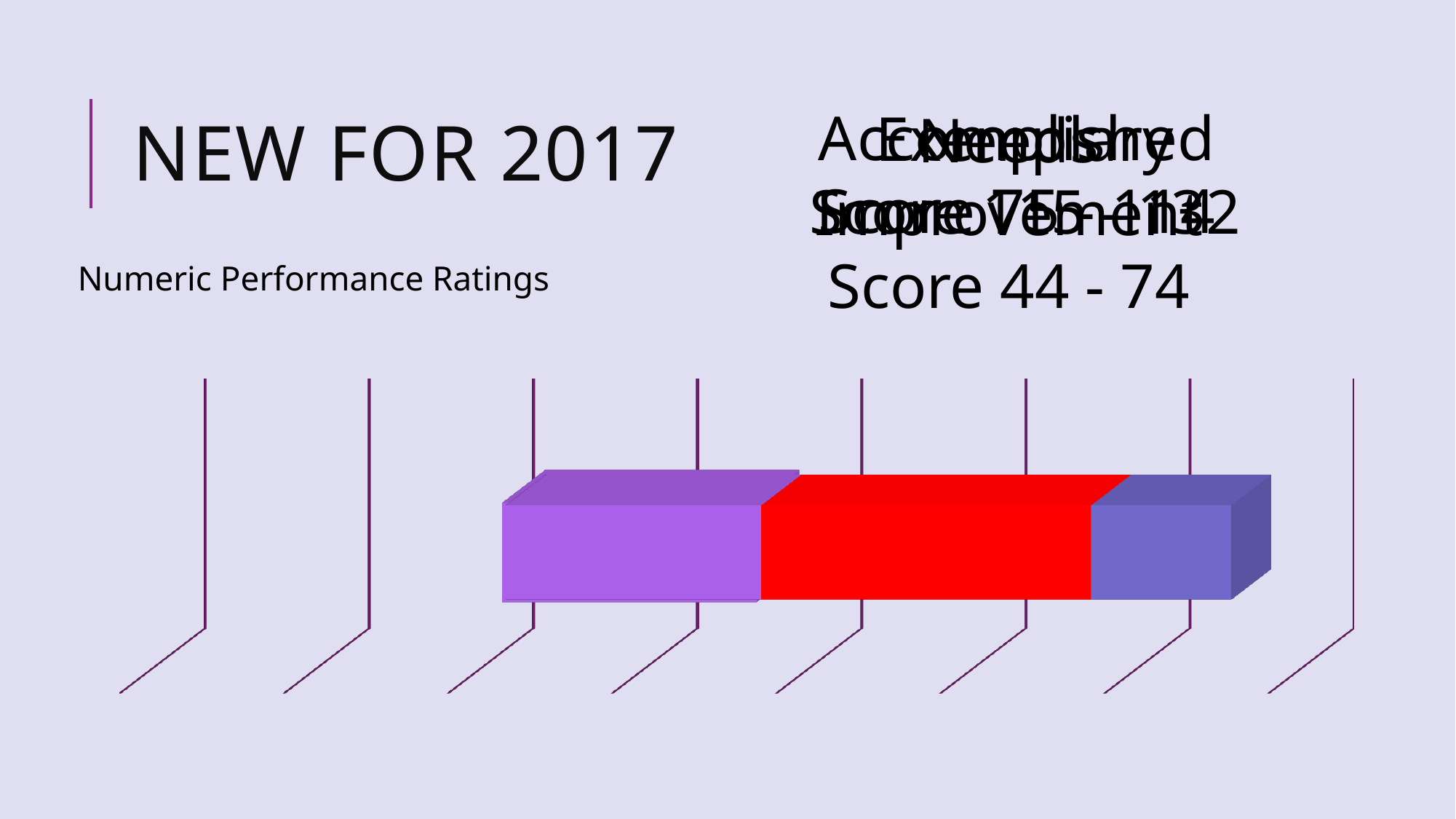
Is the red segment of the bar longer or shorter than the purple segment? longer Is the bar in the chart drawn horizontally or vertically? horizontally What colours are the three segments of the bar, from left to right? purple, red, blue Which colour segment of the stacked bar is the longest? red What kind of chart is shown on the slide? bar chart How many coloured segments make up the stacked bar? 3 How many bars are plotted in the chart? 1 Which colour segment of the stacked bar is the shortest? blue Is the blue segment of the bar longer or shorter than the purple segment? shorter